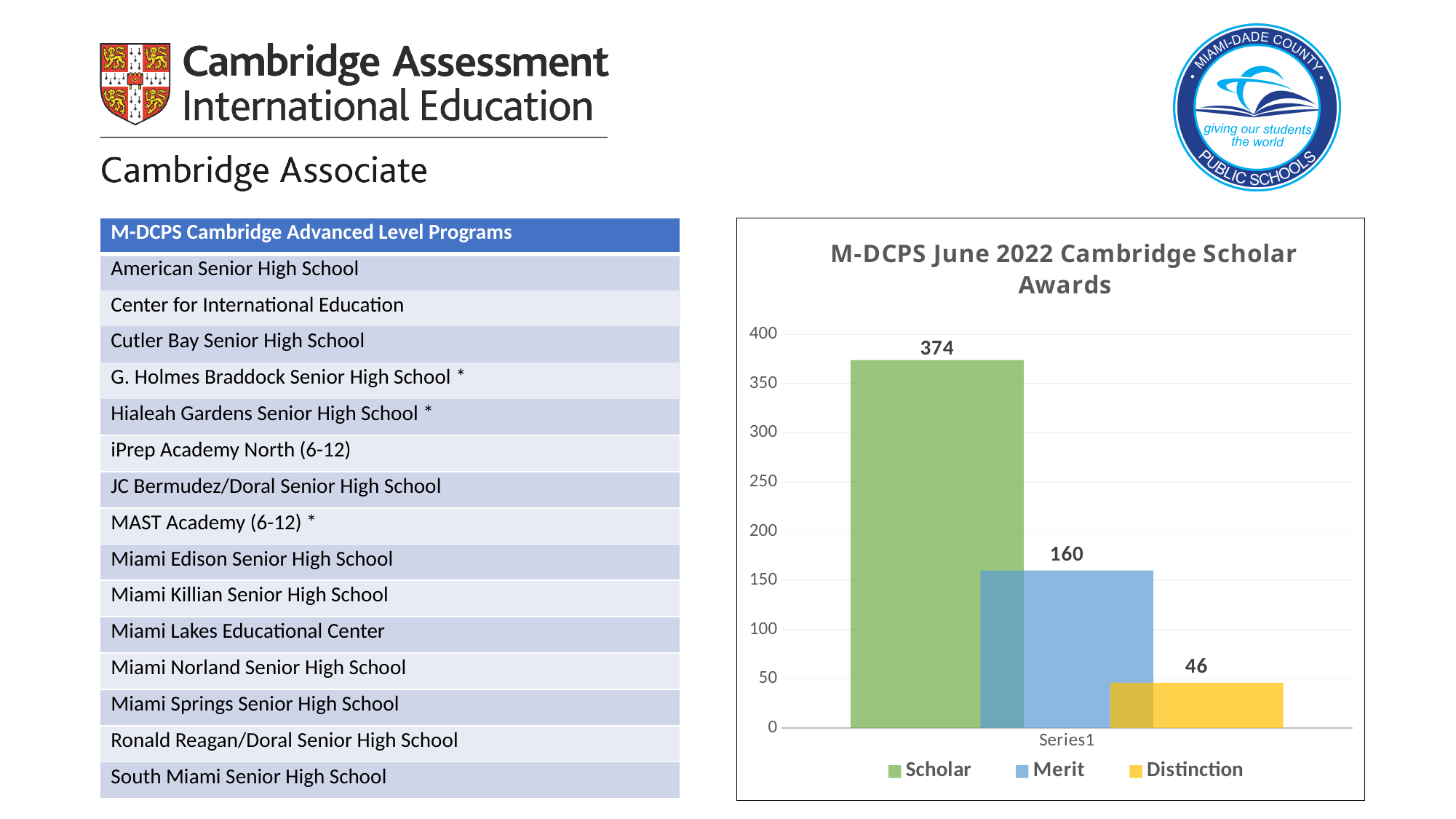
What kind of chart is shown on the slide? bar chart What is the value for Merit in the chart? 160 Which series has the highest value in the chart? Scholar Which is larger, the value for Merit or the value for Distinction? Merit What is the title of the chart on the slide? M-DCPS June 2022 Cambridge Scholar Awards How many series does the legend list in the chart? 3 What is the difference between the Scholar and Merit values? 214 Which series has the lowest value in the chart? Distinction Is the value for Scholar greater or less than 350? greater What is the difference between the Merit and Distinction values? 114 What is the value for Distinction in the chart? 46 What is the value for Scholar in the M-DCPS June 2022 Cambridge Scholar Awards chart? 374